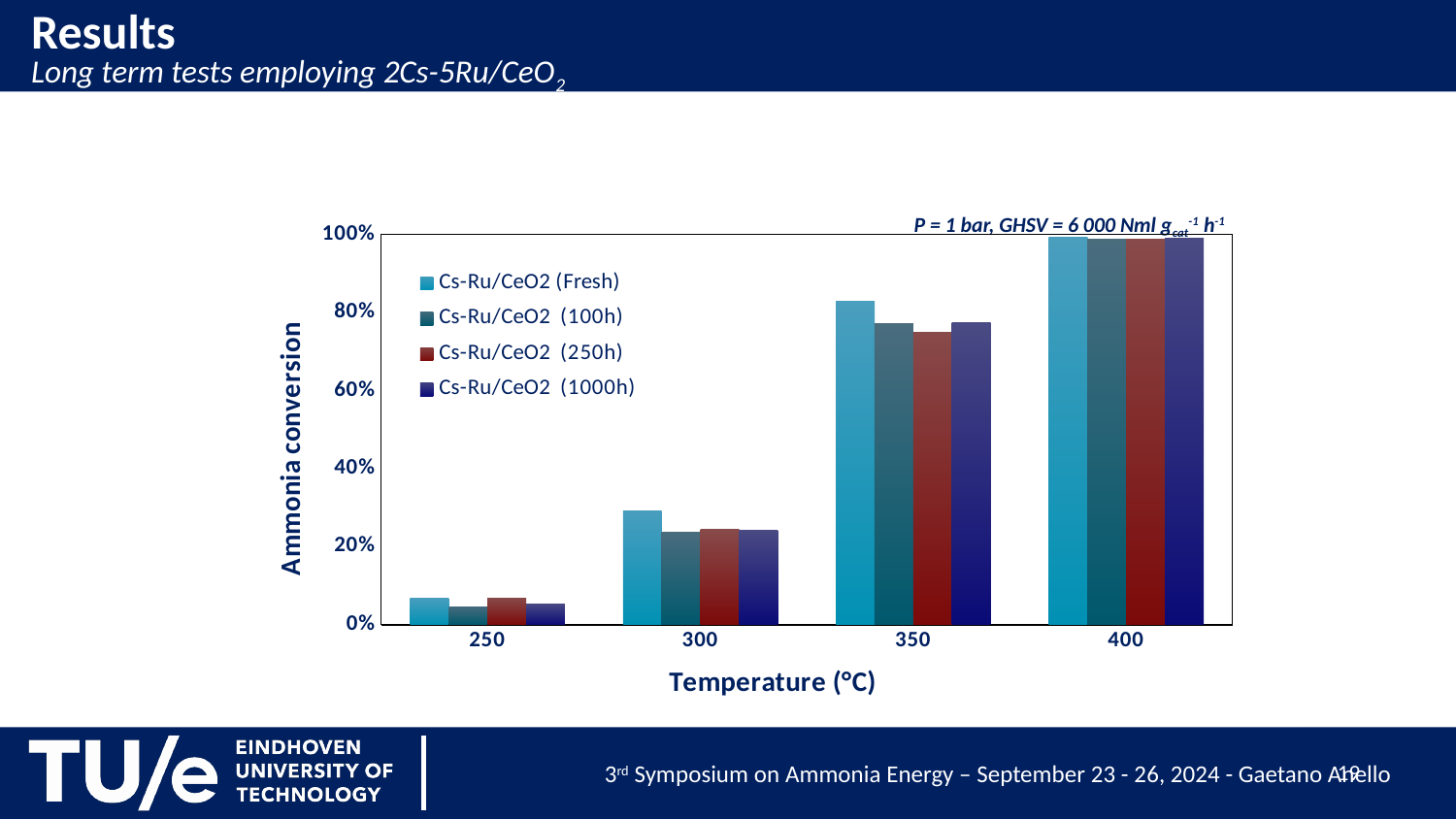
At which temperature is the ammonia conversion for Cs-Ru/CeO2 (Fresh) highest? 400 At 300 °C, which has the larger ammonia conversion: Cs-Ru/CeO2 (Fresh) or Cs-Ru/CeO2 (100h)? Cs-Ru/CeO2 (Fresh) Is the ammonia conversion for Cs-Ru/CeO2 (100h) at 400 °C greater or less than 80%? greater What is the label of the x axis? Temperature (°C) Is the ammonia conversion for Cs-Ru/CeO2 (Fresh) at 300 °C greater or less than 20%? greater At which temperature is the ammonia conversion for Cs-Ru/CeO2 (1000h) lowest? 250 What is the label of the y axis? Ammonia conversion How many series does the legend list? 4 How many temperature categories are shown on the x axis? 4 Does the ammonia conversion for Cs-Ru/CeO2 (Fresh) rise or fall as temperature increases from 250 to 400 °C? rise Is the ammonia conversion for Cs-Ru/CeO2 (250h) at 250 °C greater or less than 20%? less What kind of chart is shown on the slide? bar chart